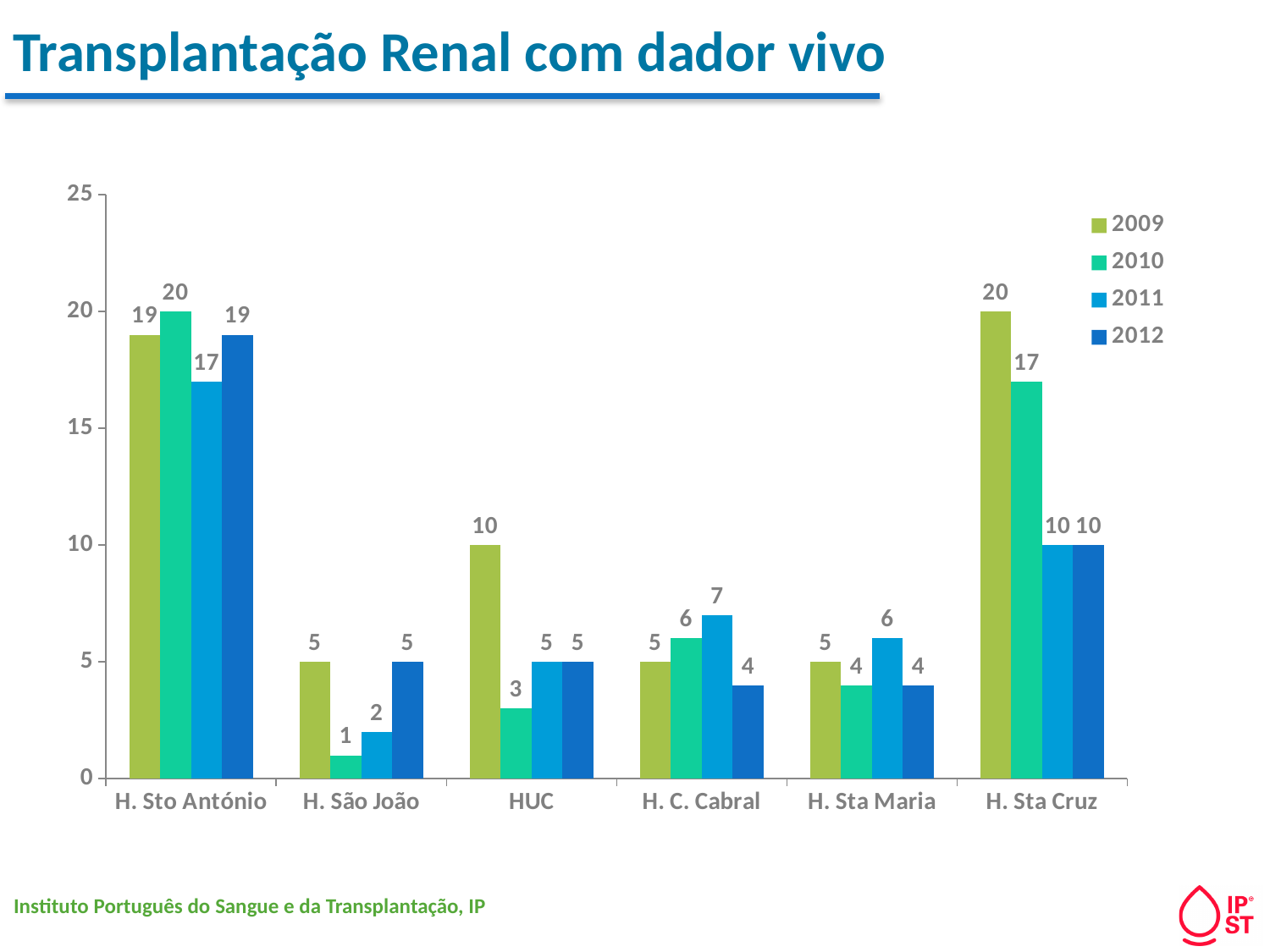
What is the value for HUC in 2009? 10 Which hospital has the lowest value in 2010? H. São João What is the value for H. Sto António in 2011? 17 Do the values for H. Sta Cruz rise or fall from 2009 to 2012? Fall What kind of chart is shown on the slide? Bar chart How many series does the legend list? 4 How many hospitals are shown on the x axis? 6 Which is larger for H. C. Cabral: the 2011 value or the 2012 value? 2011 What is the value for H. São João in 2010? 1 What is the title of the chart? Transplantação Renal com dador vivo What is the difference between the 2009 and 2011 values for H. Sta Cruz? 10 Which hospital has the highest value in 2012? H. Sto António